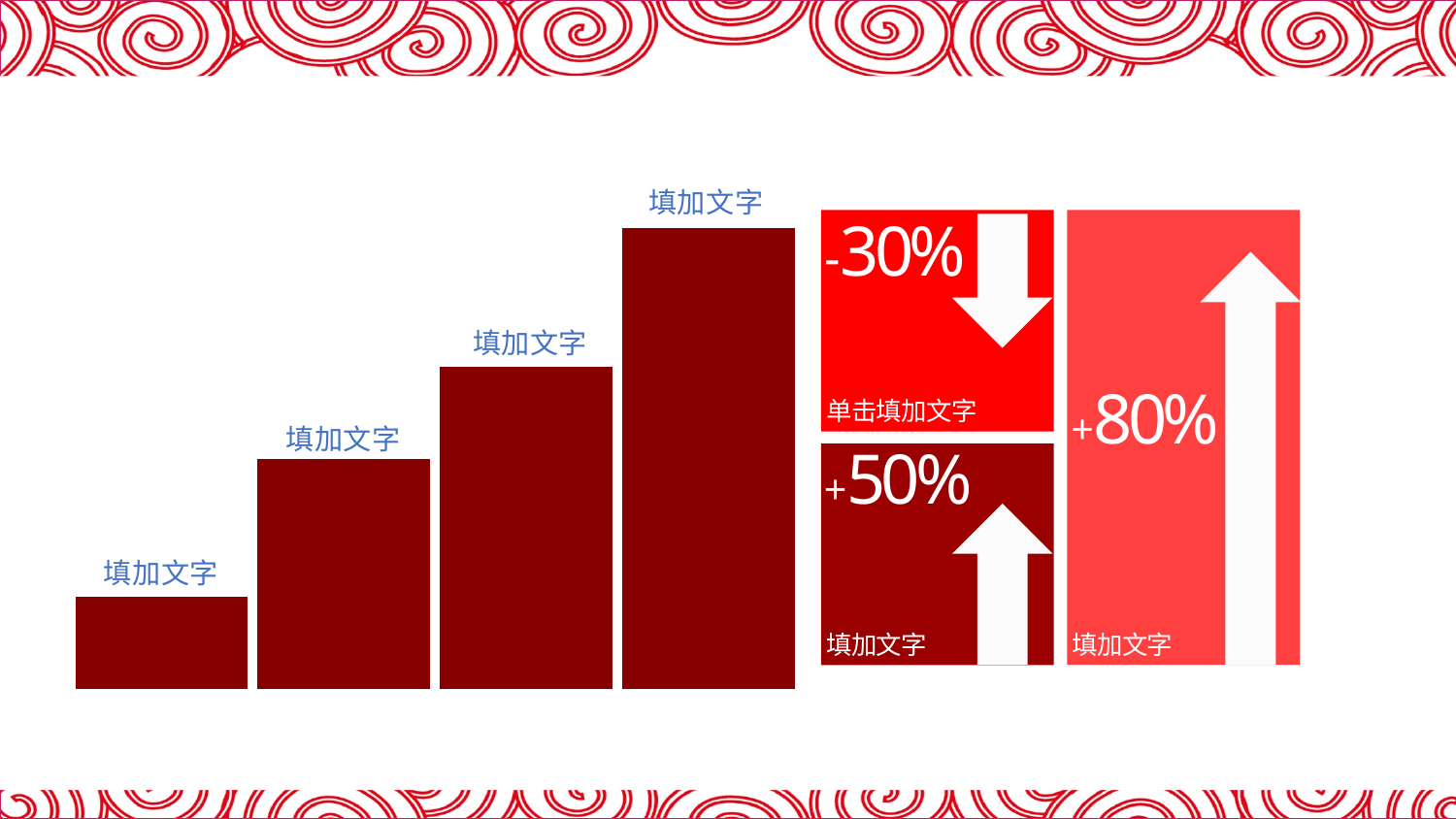
Do the bars in the bar chart rise or fall from left to right? rise What colour are the bars in the bar chart? dark red Are the bars in the bar chart vertical or horizontal? vertical In the bar chart, is the second bar from the left taller or shorter than the third bar from the left? shorter Which bar in the bar chart is the tallest, counting from the left? the fourth (rightmost) bar What kind of chart is shown on the left of the slide? bar chart How many bars does the bar chart on the left of the slide have? 4 Which bar in the bar chart is the shortest, counting from the left? the first (leftmost) bar